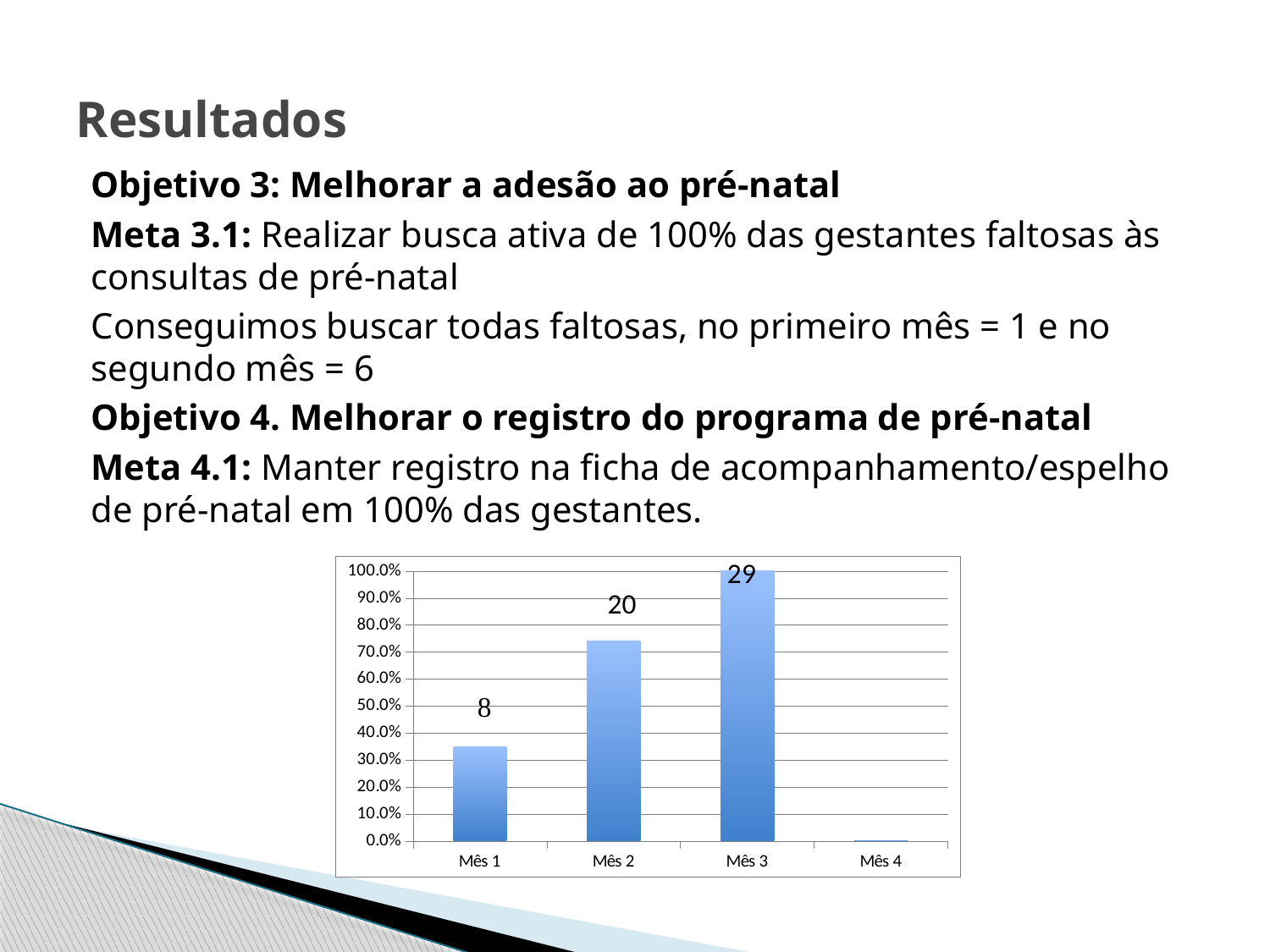
What is the data label shown on the bar for Mês 1? 8 Which month has the tallest bar in the chart? Mês 3 Is the bar for Mês 2 greater or less than 60.0% on the y axis? greater What is the data label shown on the bar for Mês 3? 29 What is the difference between the data labels for Mês 2 and Mês 1? 12 How many month categories are shown on the x axis of the chart? 4 What type of chart is shown on the slide? Bar chart What is the difference between the data labels for Mês 3 and Mês 1? 21 Which bar is taller, Mês 1 or Mês 2? Mês 2 What is the data label shown on the bar for Mês 2? 20 Is the bar for Mês 1 greater or less than 40.0% on the y axis? less Among the bars with data labels, which month has the smallest label value? Mês 1